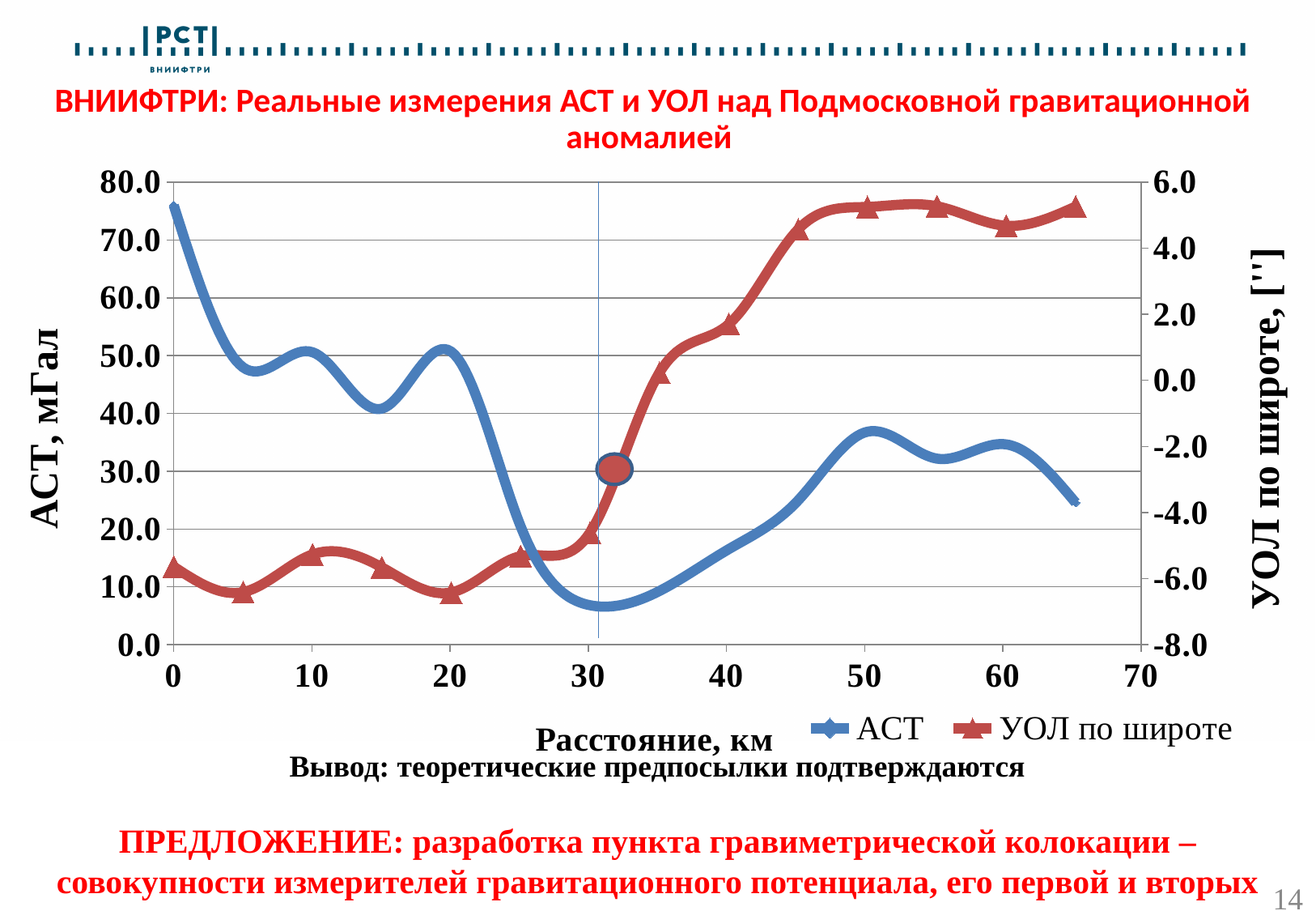
Does the УОЛ по широте series rise or fall between 30 km and 50 km? rise How many series does the legend list? 2 Is the УОЛ по широте value at 40 km greater or less than 0.0? greater Does the АСТ series rise or fall between 0 km and 30 km? fall What is the title of the x axis? Расстояние, км Is the АСТ value at 30 km greater or less than 10.0? less What kind of chart is shown on the slide? line chart What are the two series named in the legend? АСТ and УОЛ по широте Is the АСТ value at 50 km greater or less than 30.0? greater